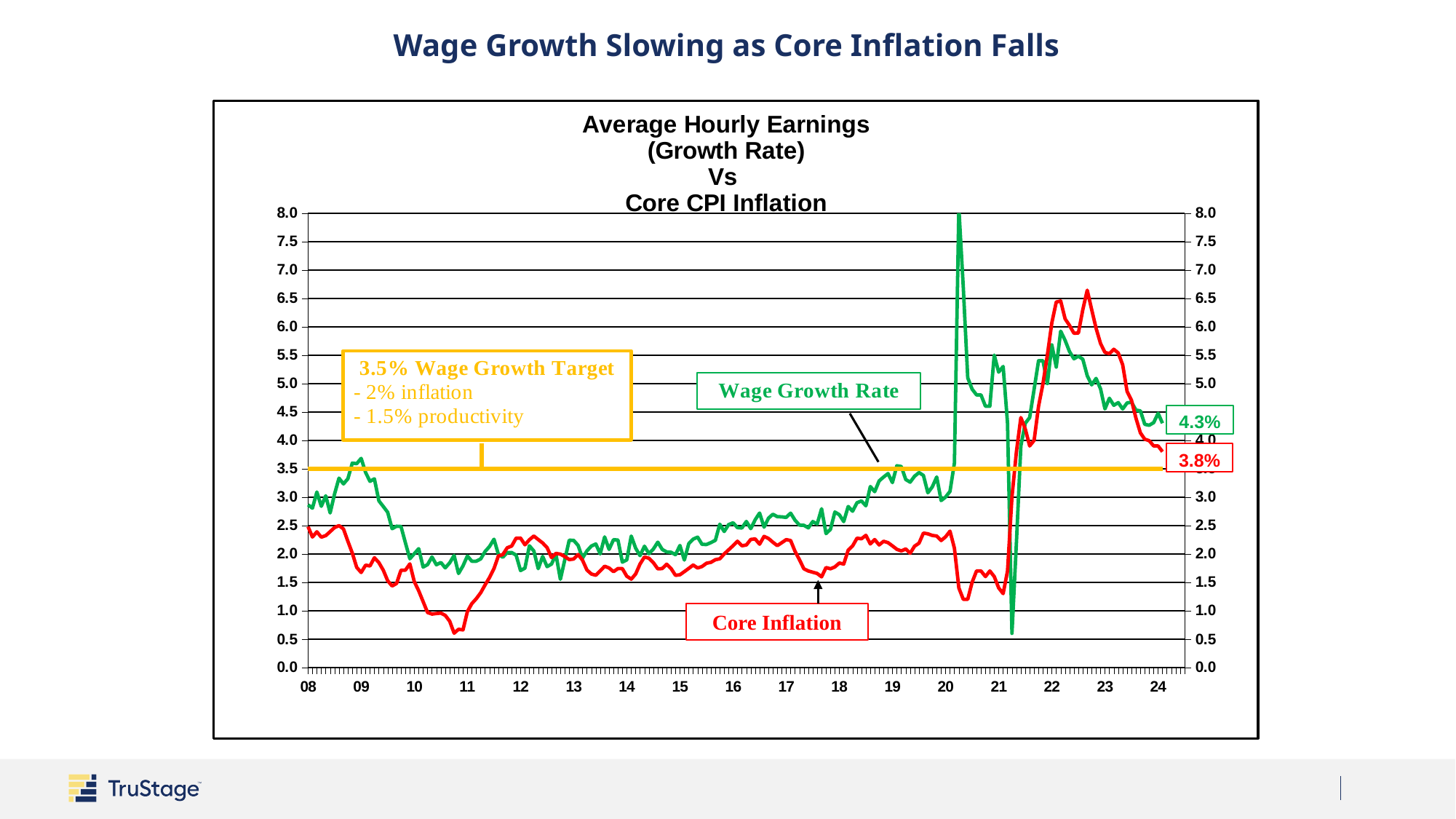
Is the lowest value of Core Inflation around 2010-2011 greater or less than 1.0? less What is the difference between the latest labelled Wage Growth Rate (4.3%) and the latest labelled Core Inflation (3.8%)? 0.5% Which series reaches the highest value anywhere on the chart? Wage Growth Rate What kind of chart is shown on the slide? line chart How many data series are plotted on the chart? 3 Does the Wage Growth Rate rise or fall from 2022 to 2024? fall Is the peak of the Wage Growth Rate around 2020 greater or less than 7.0? greater Is the peak of Core Inflation around 2022 greater or less than 6.0? greater What value is the horizontal Wage Growth Target line drawn at? 3.5% At the end of the chart, which is larger: the Wage Growth Rate or Core Inflation? Wage Growth Rate What is the latest labelled value of the Wage Growth Rate? 4.3% What is the latest labelled value of Core Inflation? 3.8%